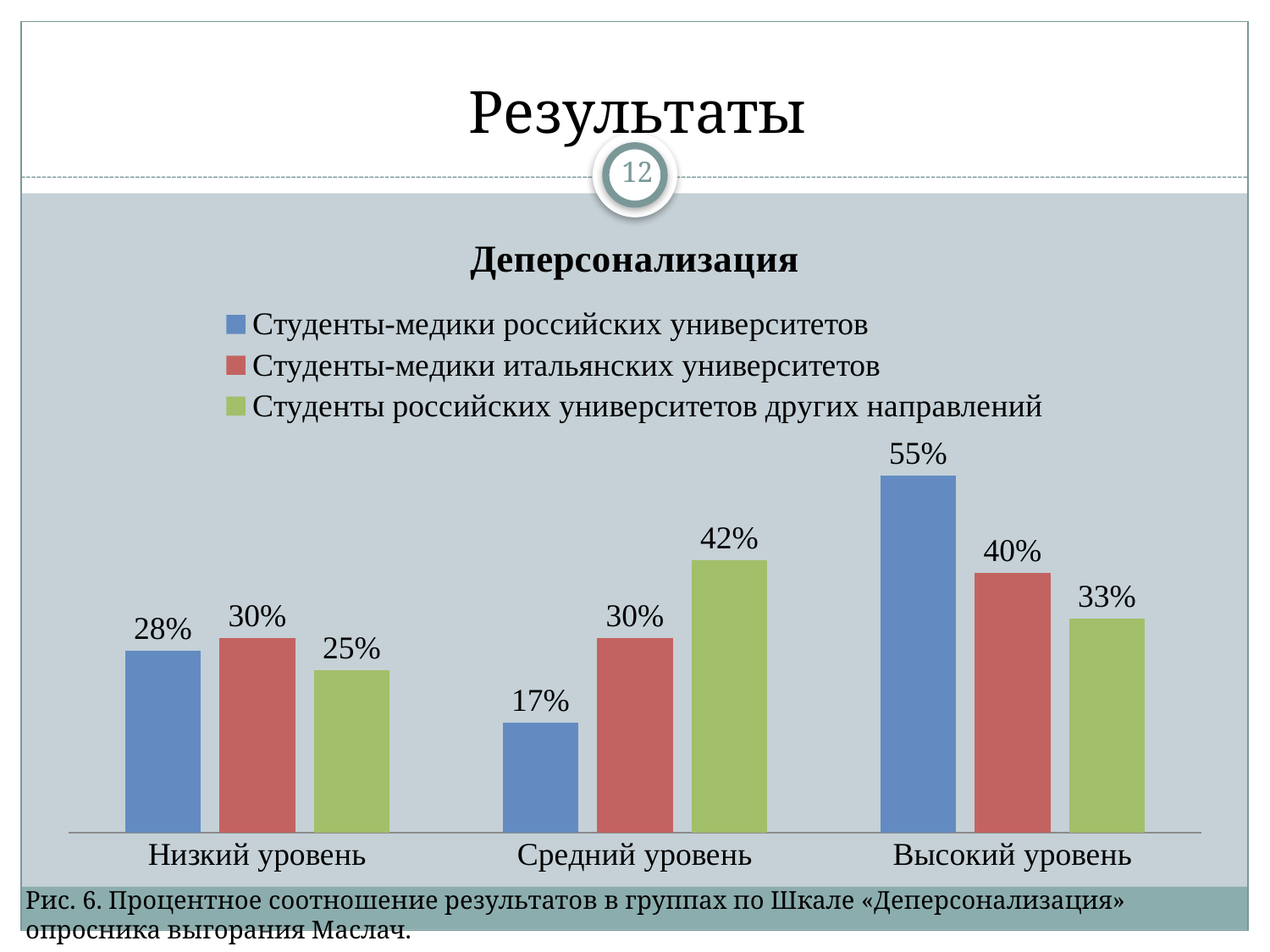
What is the difference between Студенты-медики российских университетов and Студенты российских универ��итетов других направлений at Высокий уровень? 22% What is the value for Студенты-медики итальянских университетов at Низкий уровень? 30% How many categories are shown on the x axis? 3 Do the values for Студенты-медики итальянских университетов rise or fall from Низкий уровень to Высокий уровень? Rise At Средний уровень, which is larger: Студенты-медики итальянских университетов or Студенты российских университетов других направлений? Студенты российских университетов других направлений How many series does the legend list? 3 Which category has the lowest value for Студенты-медики российских университетов? Средний уровень What kind of chart is shown? Bar chart What is the title of the chart? Деперсонализация Which category has the highest value for Студенты-медики российских университетов? Высокий уровень What is the value for Студенты российских университетов других направлений at Средний уровень? 42% What is the value for Студенты-медики российских университетов at Высокий уровень? 55%